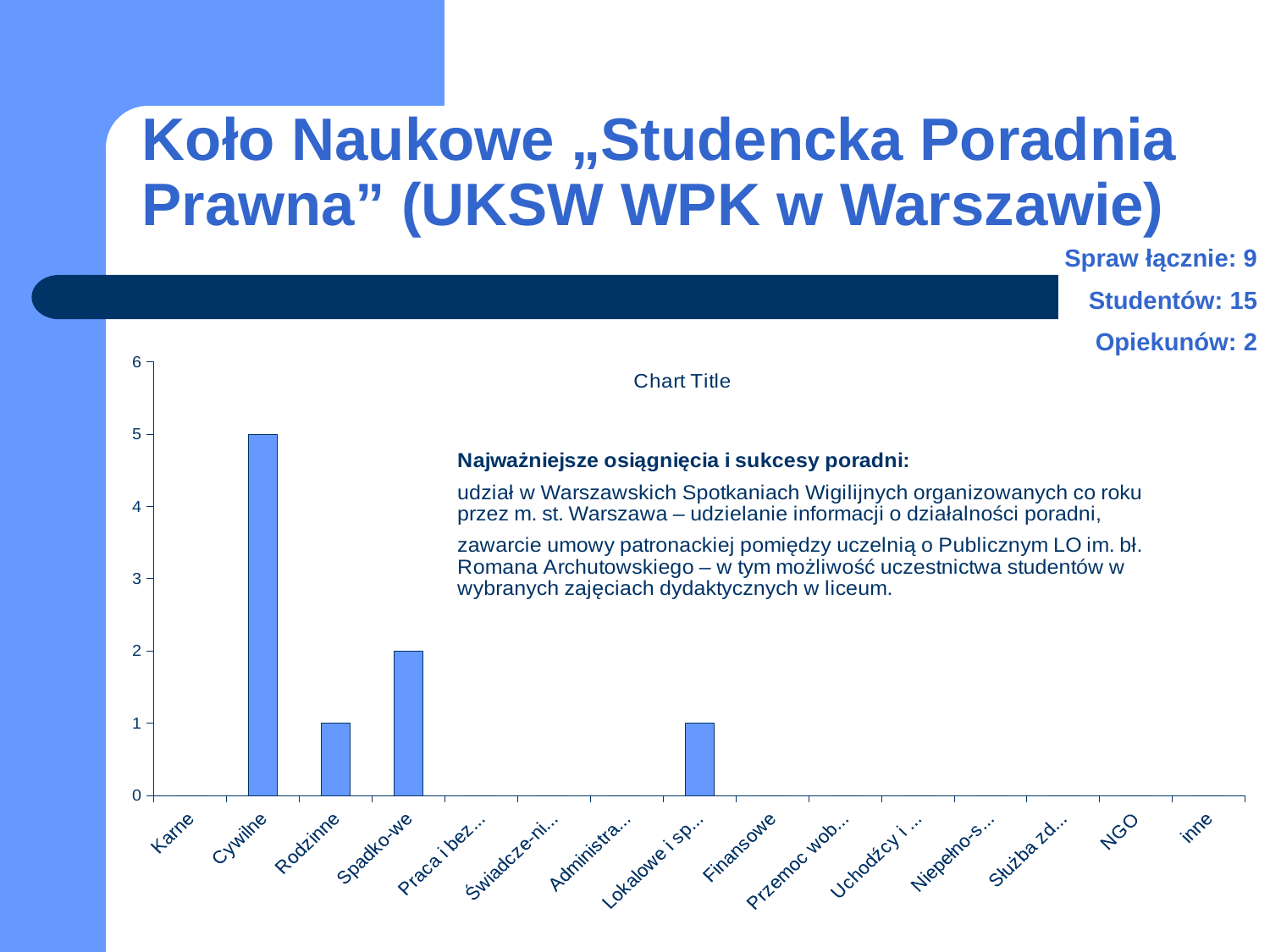
How many categories are shown on the x axis? 15 What is the highest value shown on the vertical axis? 6 What is the difference between the values for Cywilne and Spadko-we? 3 Which is larger, the value for Spadko-we or the value for Rodzinne? Spadko-we What is the value for Cywilne? 5 What is the value for Lokalowe i sp...? 1 What kind of chart is shown on the slide? bar chart Which category has the highest value? Cywilne Is the value for Cywilne greater or less than 4? greater What is the value for Spadko-we? 2 What is the value for Rodzinne? 1 What is the title of the chart? Chart Title